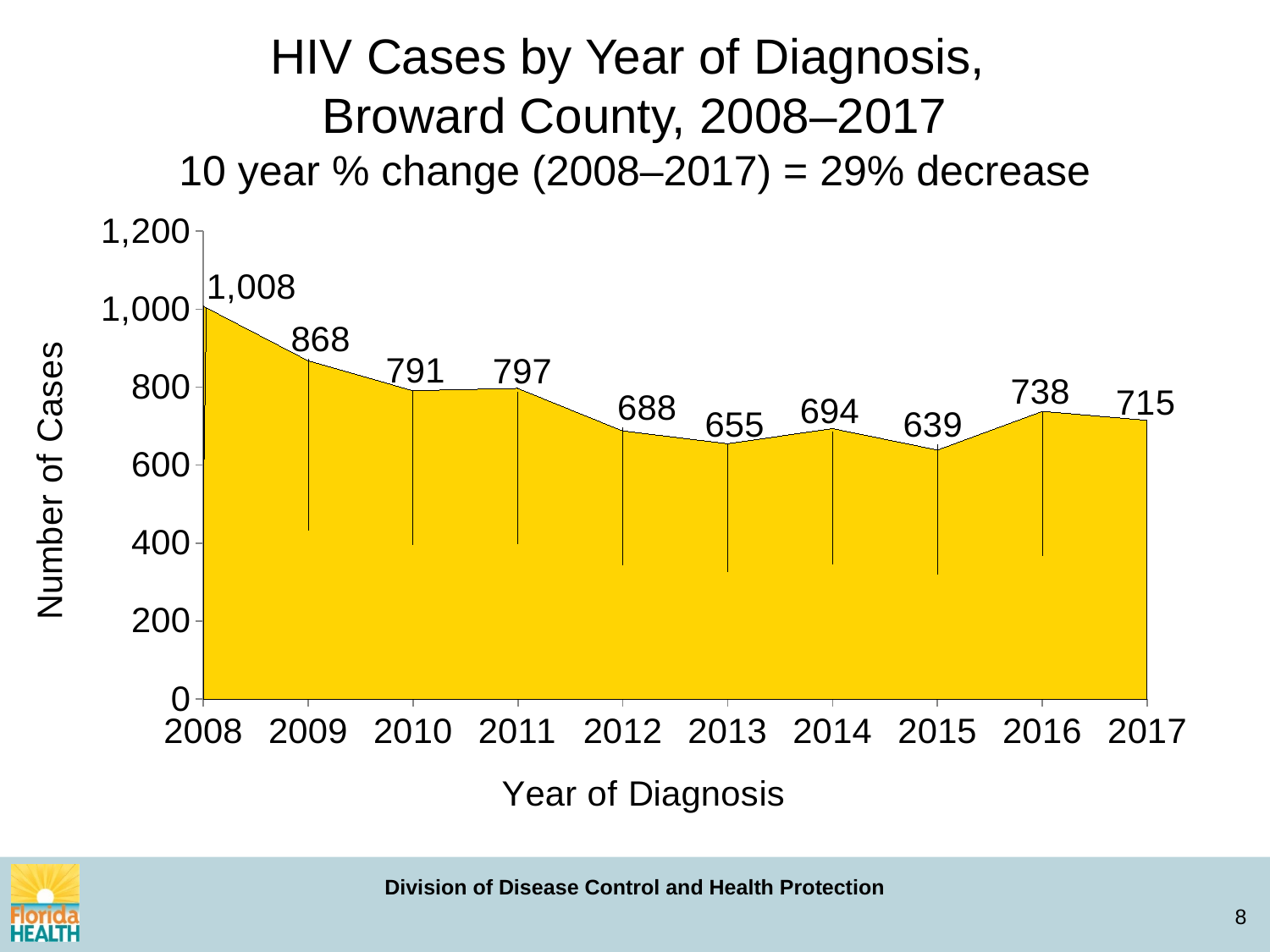
What 10 year % change (2008–2017) is stated in the chart title? 29% decrease Which year has the lowest number of cases? 2015 What is the number of cases for 2017? 715 How many years are plotted on the chart? 10 Which year had more cases, 2011 or 2010? 2011 What is the difference in cases between 2016 and 2015? 99 What kind of chart is shown on the slide? Area chart What is the number of cases for 2013? 655 How many HIV cases were diagnosed in Broward County in 2008? 1,008 Do the number of cases generally rise or fall from 2008 to 2017? Fall Which year has the highest number of cases? 2008 What is the difference in cases between 2008 and 2017? 293